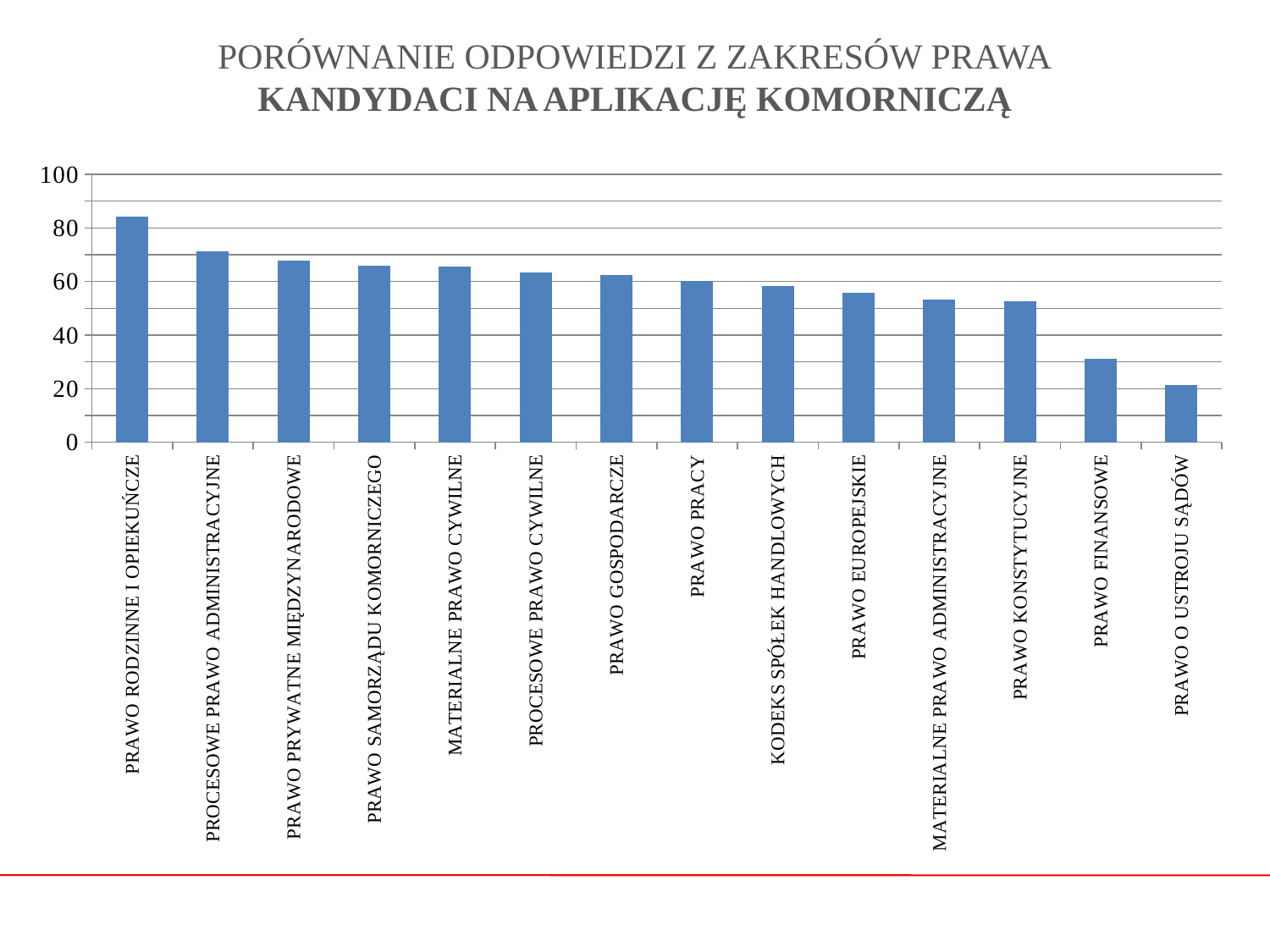
Is the value for PRAWO RODZINNE I OPIEKUŃCZE greater or less than 80? greater Do the bar values rise or fall from left to right along the x axis? fall What kind of chart is shown on the slide? bar chart Is the value for PRAWO FINANSOWE greater or less than 40? less Is the value for PRAWO KONSTYTUCYJNE greater or less than 60? less What is the bold second line of the chart's title? KANDYDACI NA APLIKACJĘ KOMORNICZĄ How many categories (areas of law) are plotted in the chart? 14 Which area of law has the highest bar in the chart? PRAWO RODZINNE I OPIEKUŃCZE Which is larger, the value for PRAWO FINANSOWE or the value for PRAWO O USTROJU SĄDÓW? PRAWO FINANSOWE Which area of law has the lowest bar in the chart? PRAWO O USTROJU SĄDÓW